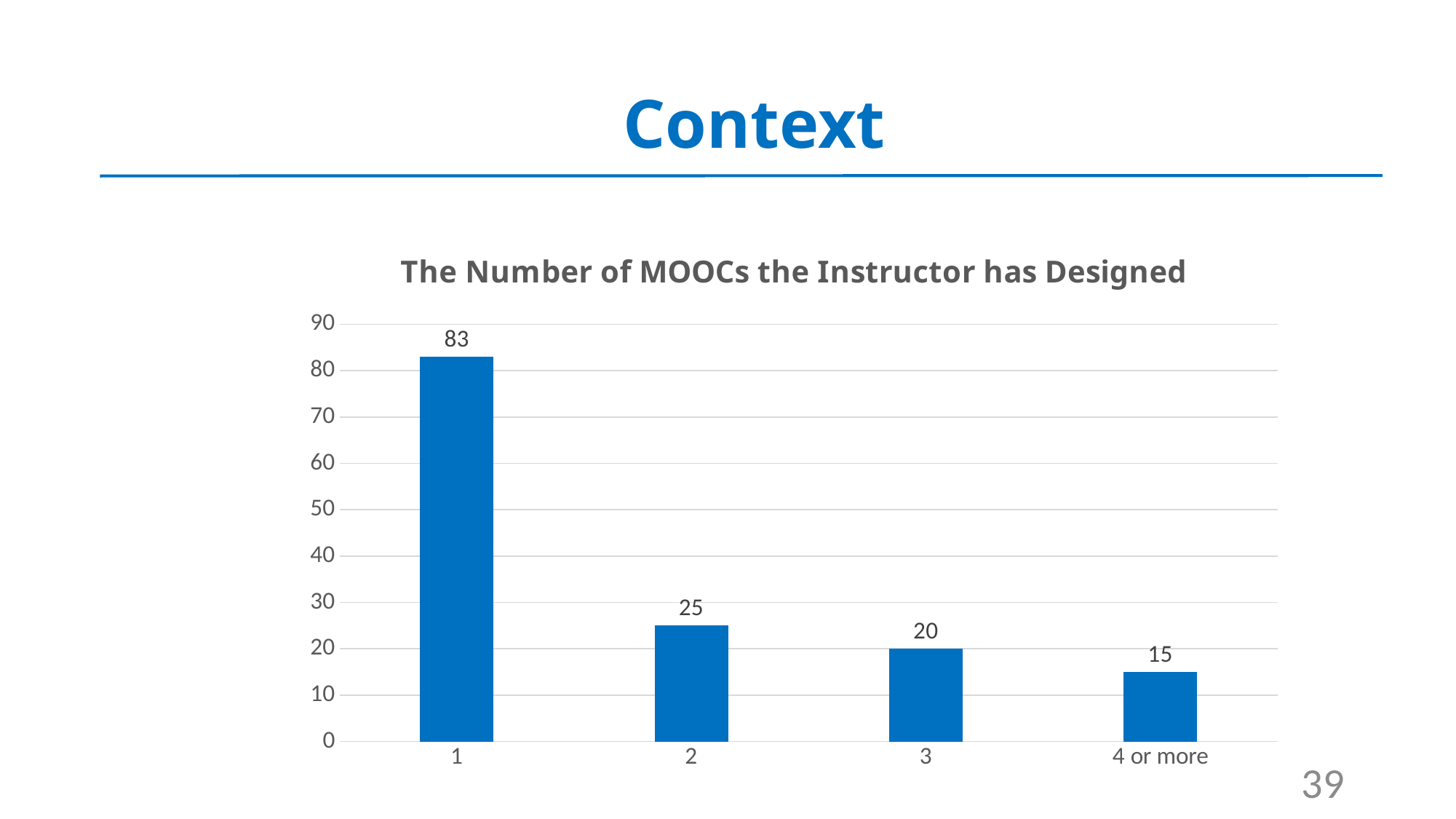
Which category has the lowest value? 4 or more What is the value for the category "1"? 83 What is the difference between the values for "3" and "4 or more"? 5 What is the value for the category "4 or more"? 15 What kind of chart is shown on the slide? Bar chart Which category has the highest value? 1 How many categories are shown on the x axis? 4 What is the title of the chart? The Number of MOOCs the Instructor has Designed Which is larger, the value for "2" or the value for "3"? 2 Do the values rise or fall from left to right along the x axis? Fall What is the value for the category "3"? 20 What is the difference between the values for "1" and "2"? 58